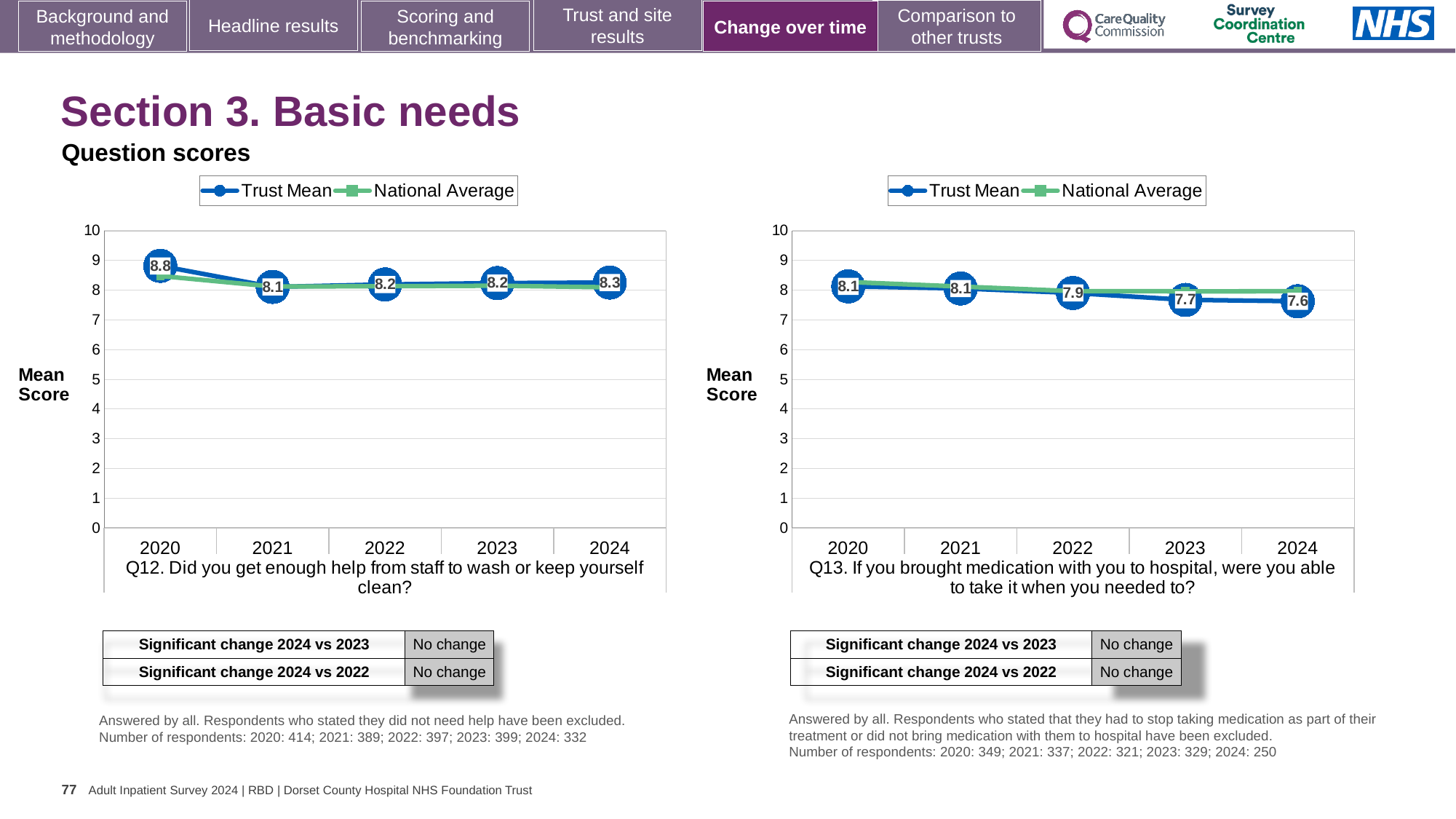
In the Q13 chart (right), what is the Trust Mean for 2022? 7.9 In the Q12 chart (left), what is the difference between the Trust Mean for 2020 and 2021? 0.7 In the Q12 chart (left), what is the Trust Mean for 2024? 8.3 How many series does the legend of the Q12 chart (left) list? 2 In the Q12 chart (left), which year has the highest Trust Mean? 2020 In the Q13 chart (right), which year has the lowest Trust Mean? 2024 In the Q12 chart (left), what is the Trust Mean for 2020? 8.8 What kind of chart is the Q13 chart (right)? line chart In the Q13 chart (right), does the Trust Mean rise or fall from 2020 to 2024? fall In the Q13 chart (right), is the Trust Mean for 2020 or 2024 larger? 2020 In the Q13 chart (right), what is the Trust Mean for 2024? 7.6 In the Q12 chart (left), how many years are plotted on the x axis? 5